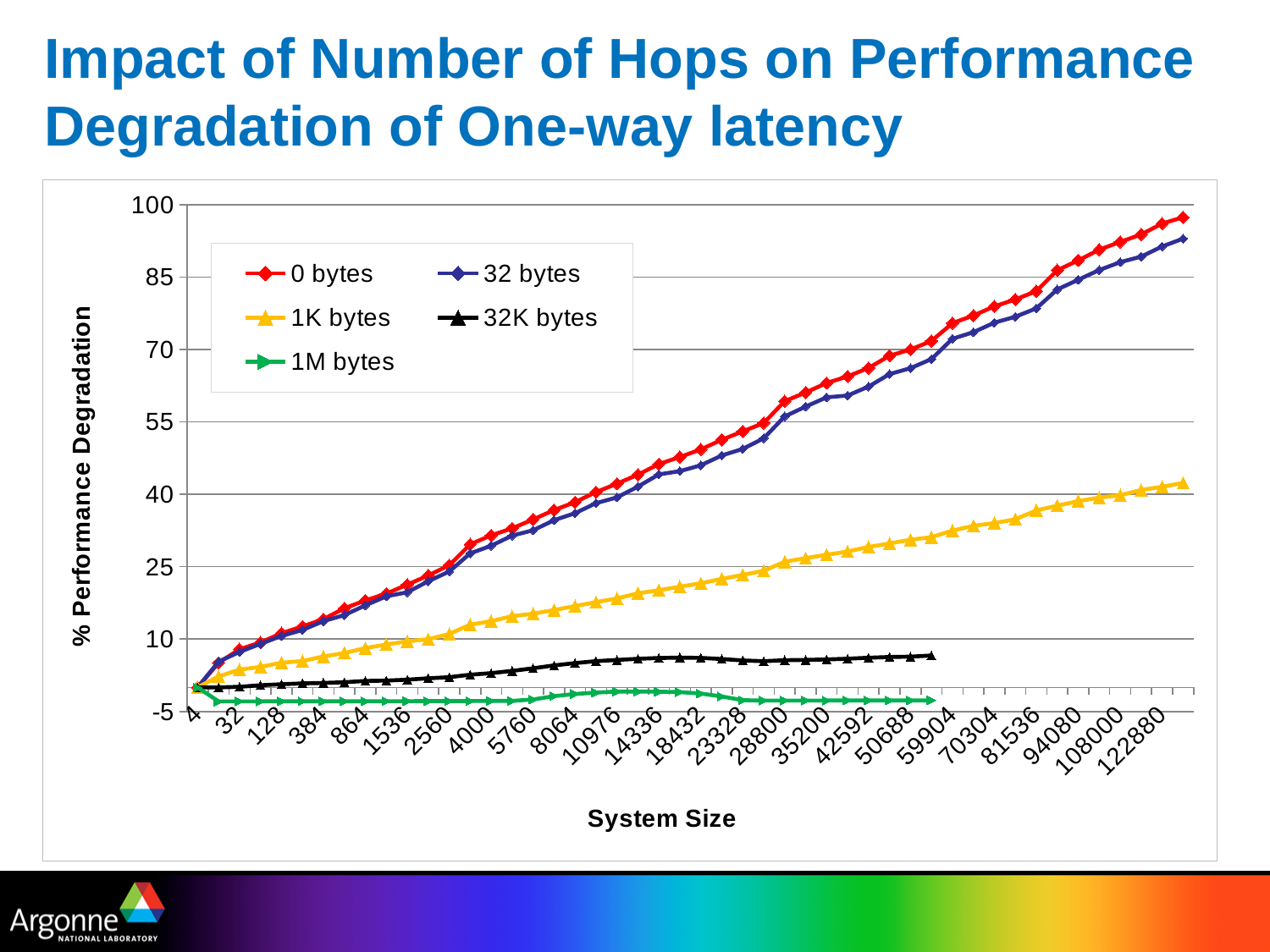
At system size 122880, which is larger: the value for 0 bytes or the value for 1K bytes? 0 bytes Is the value for 0 bytes at system size 122880 greater or less than 85? greater How many series does the legend list? 5 Is the value for 1K bytes at system size 122880 greater or less than 25? greater Is the value for 0 bytes at system size 28800 greater or less than 55? greater Which series reaches the highest % performance degradation on the chart? 0 bytes What is the title of the y axis? % Performance Degradation Which series stays lowest across the chart? 1M bytes What kind of chart is shown on the slide? line chart Does the % performance degradation for 0 bytes rise or fall as system size increases? rise What is the title of the x axis? System Size